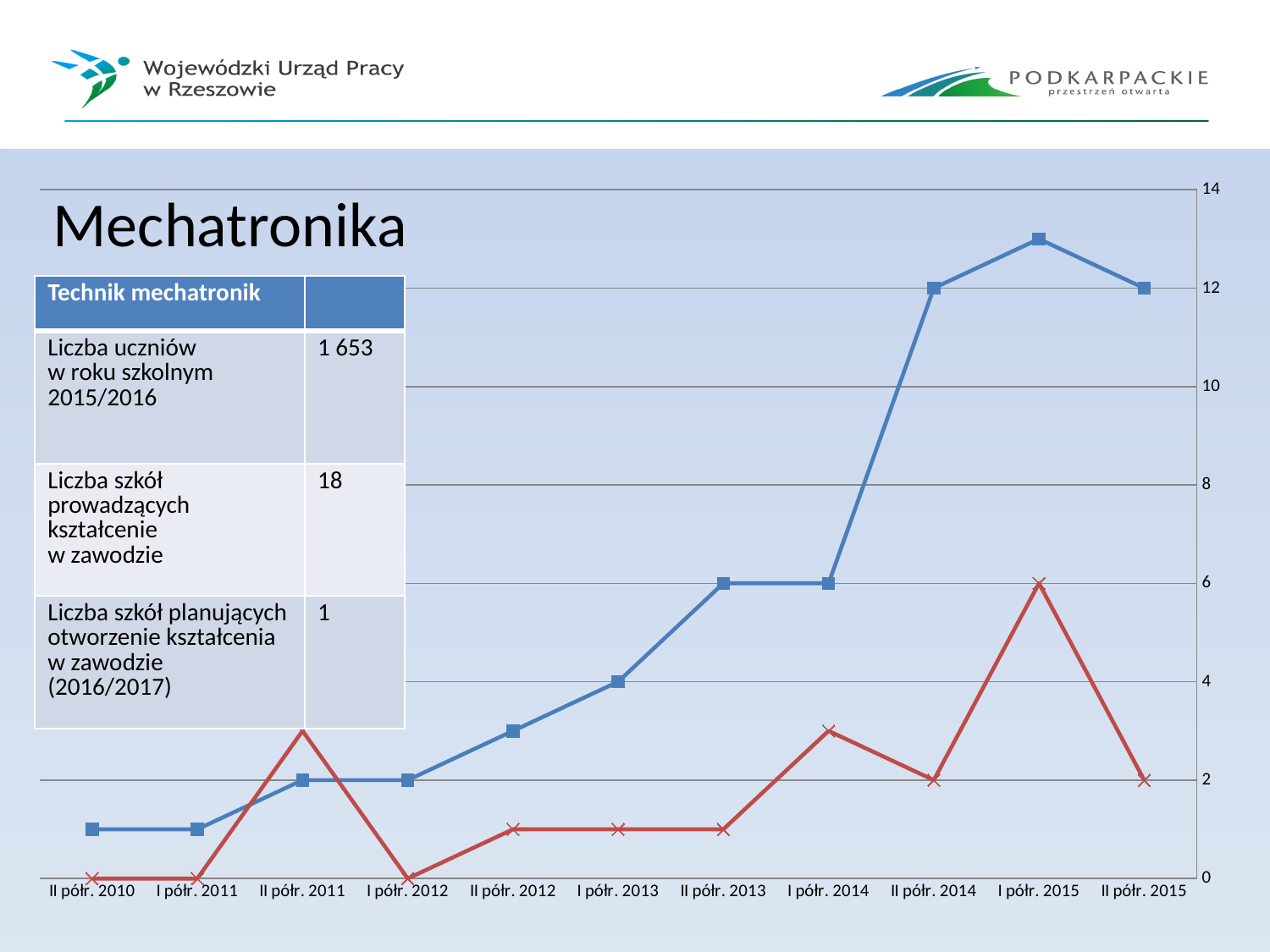
How many time periods are shown on the x axis of the chart? 11 At which period does the blue line reach its highest value? I półr. 2015 What is the value of the red line at II półr. 2015? 2 Is the value of the red line at II półr. 2011 greater or less than 2? greater What type of chart is shown on the slide? line chart Is the value of the blue line at I półr. 2015 greater or less than 12? greater At II półr. 2015, which line has the higher value, the blue or the red? blue What is the value of the blue line at II półr. 2014? 12 How many lines (data series) are plotted on the chart? 2 What is the value of the red line at I półr. 2015? 6 What is the value of the blue line at II półr. 2013? 6 What is the difference between the blue line's value at II półr. 2014 and its value at II półr. 2013? 6